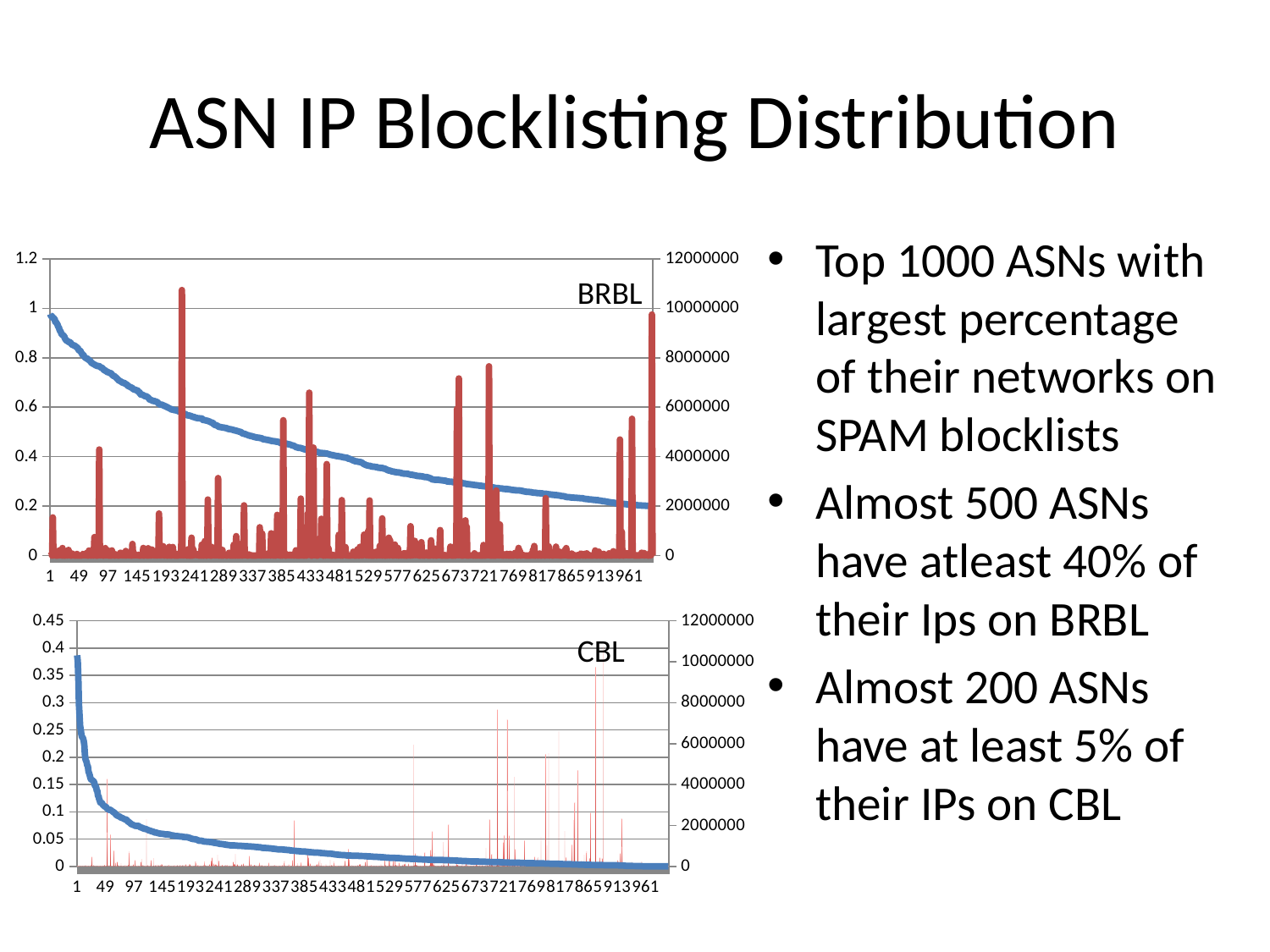
In the BRBL chart, is the blue line higher at x = 1 or at x = 961? x = 1 What label appears in the top chart on the slide? BRBL What kind of chart is the BRBL chart at the top of the slide? a combined line and bar chart In the BRBL chart, is the tallest red bar greater or less than 10000000 on the right axis? greater In the CBL chart, is the value of the blue line at x = 1 greater or less than 0.3? greater How many charts are shown on the slide? 2 In the BRBL chart, does the blue line rise or fall along the x axis? fall In the BRBL chart, is the value of the blue line at x = 961 greater or less than 0.4? less What is the maximum value shown on the left axis of the CBL chart? 0.45 In the CBL chart, does the blue line rise or fall along the x axis? fall